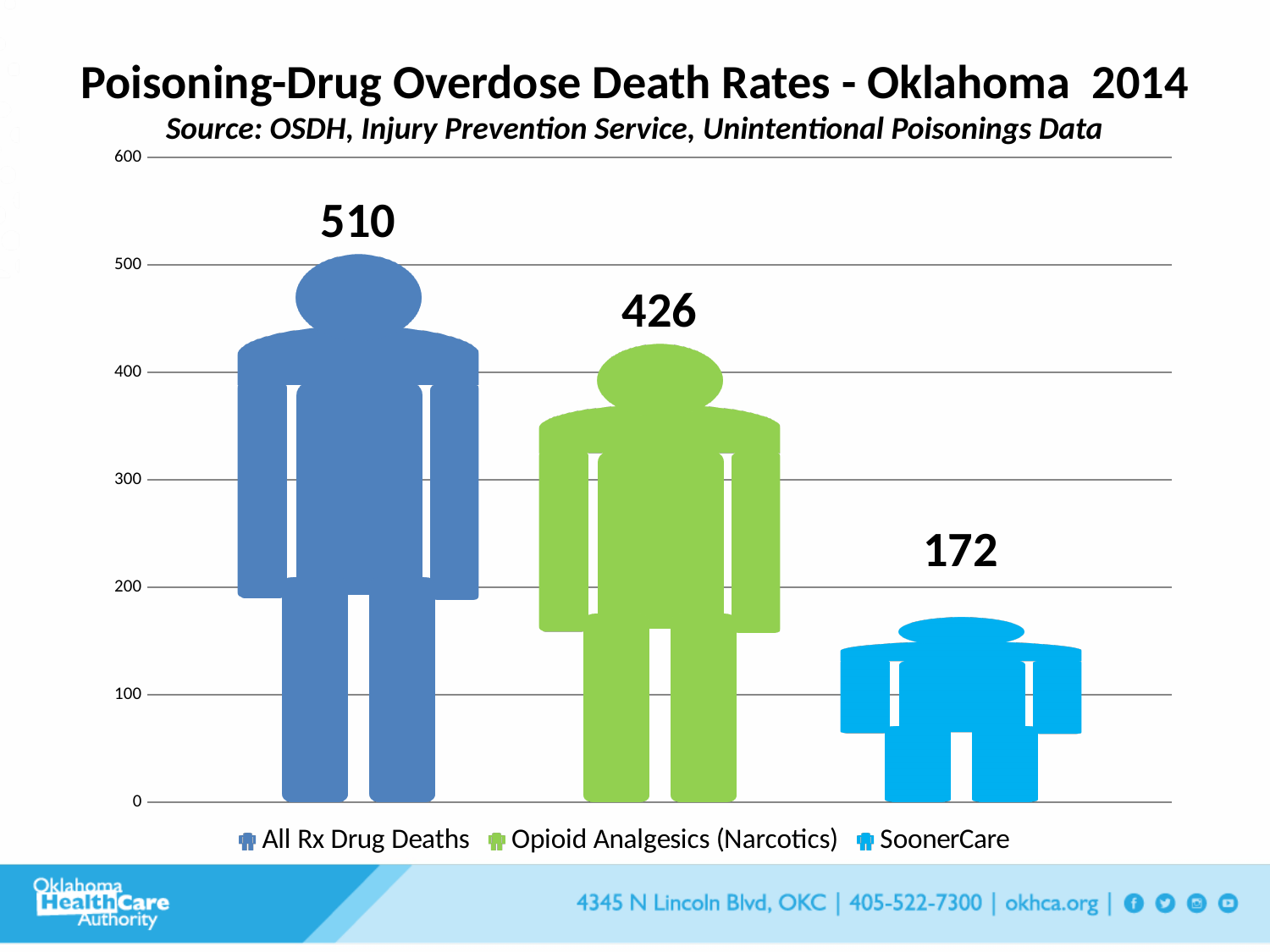
What colour is the figure for SoonerCare? Light blue Is the value for SoonerCare greater or less than 200? less Which series has the lowest value? SoonerCare What is the difference between Opioid Analgesics (Narcotics) and SoonerCare? 254 How many series does the legend list? 3 What is the value for SoonerCare? 172 Which series has the highest value? All Rx Drug Deaths What is the value for All Rx Drug Deaths? 510 What is the value for Opioid Analgesics (Narcotics)? 426 Which is larger, Opioid Analgesics (Narcotics) or SoonerCare? Opioid Analgesics (Narcotics) What is the difference between All Rx Drug Deaths and Opioid Analgesics (Narcotics)? 84 What is the title of the chart? Poisoning-Drug Overdose Death Rates - Oklahoma 2014